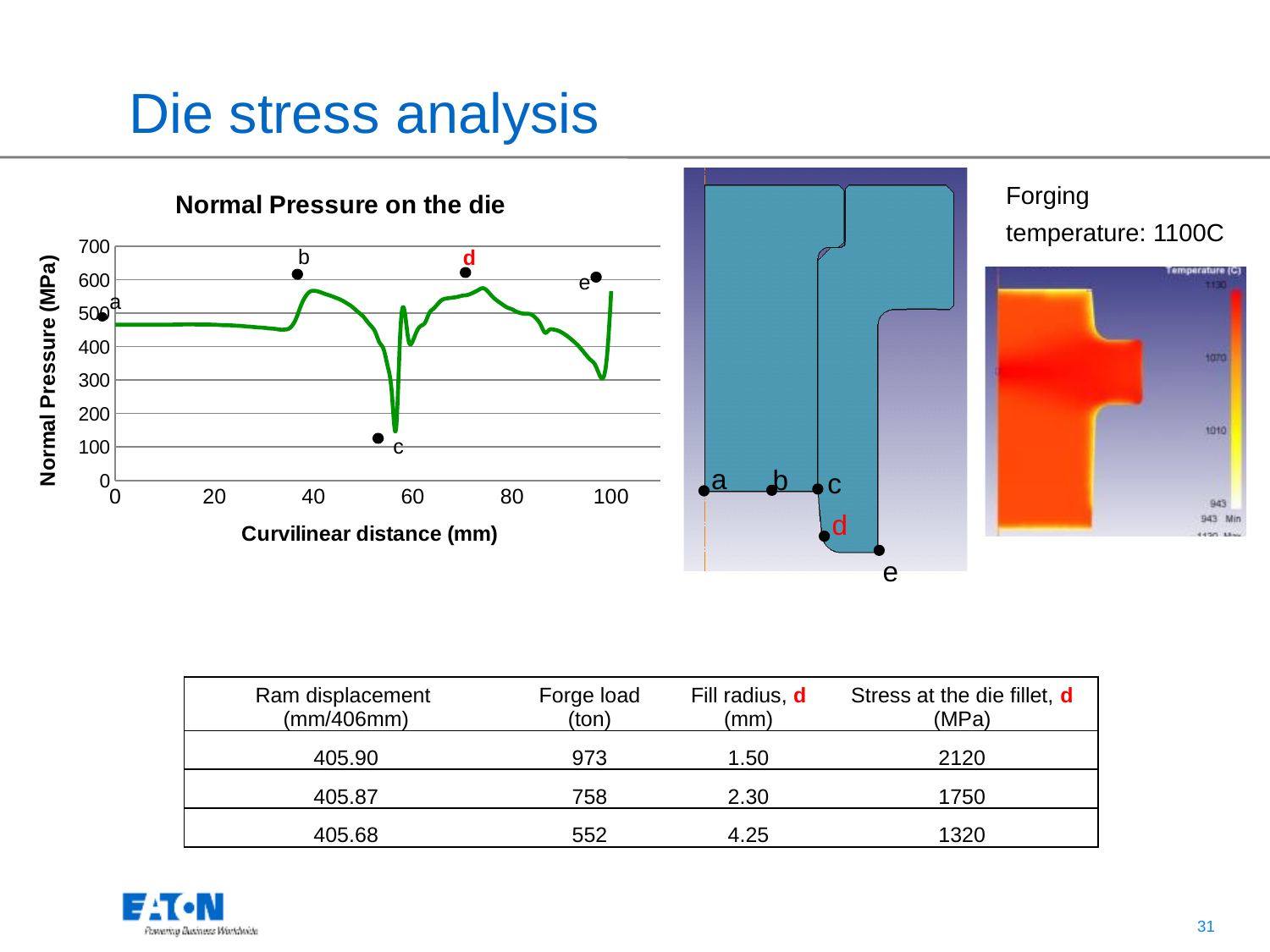
In the "Normal Pressure on the die" chart, what is the highest value shown on the y-axis? 700 In the "Normal Pressure on the die" chart, is the normal pressure at a curvilinear distance of 70 mm greater or less than 500? greater In the "Normal Pressure on the die" chart, near which labeled point does the normal pressure reach its lowest value? c In the "Normal Pressure on the die" chart, is the normal pressure at a curvilinear distance of 40 mm greater or less than 500? greater In the "Normal Pressure on the die" chart, is the lowest normal pressure on the curve greater or less than 200? less What kind of chart is "Normal Pressure on the die"? line chart In the "Normal Pressure on the die" chart, is the normal pressure at 40 mm higher or lower than at 20 mm? higher What is the title of the chart on the left of the slide? Normal Pressure on the die What is the x-axis title of the "Normal Pressure on the die" chart? Curvilinear distance (mm) In the "Normal Pressure on the die" chart, how many labeled points (letters) are marked on the curve? 5